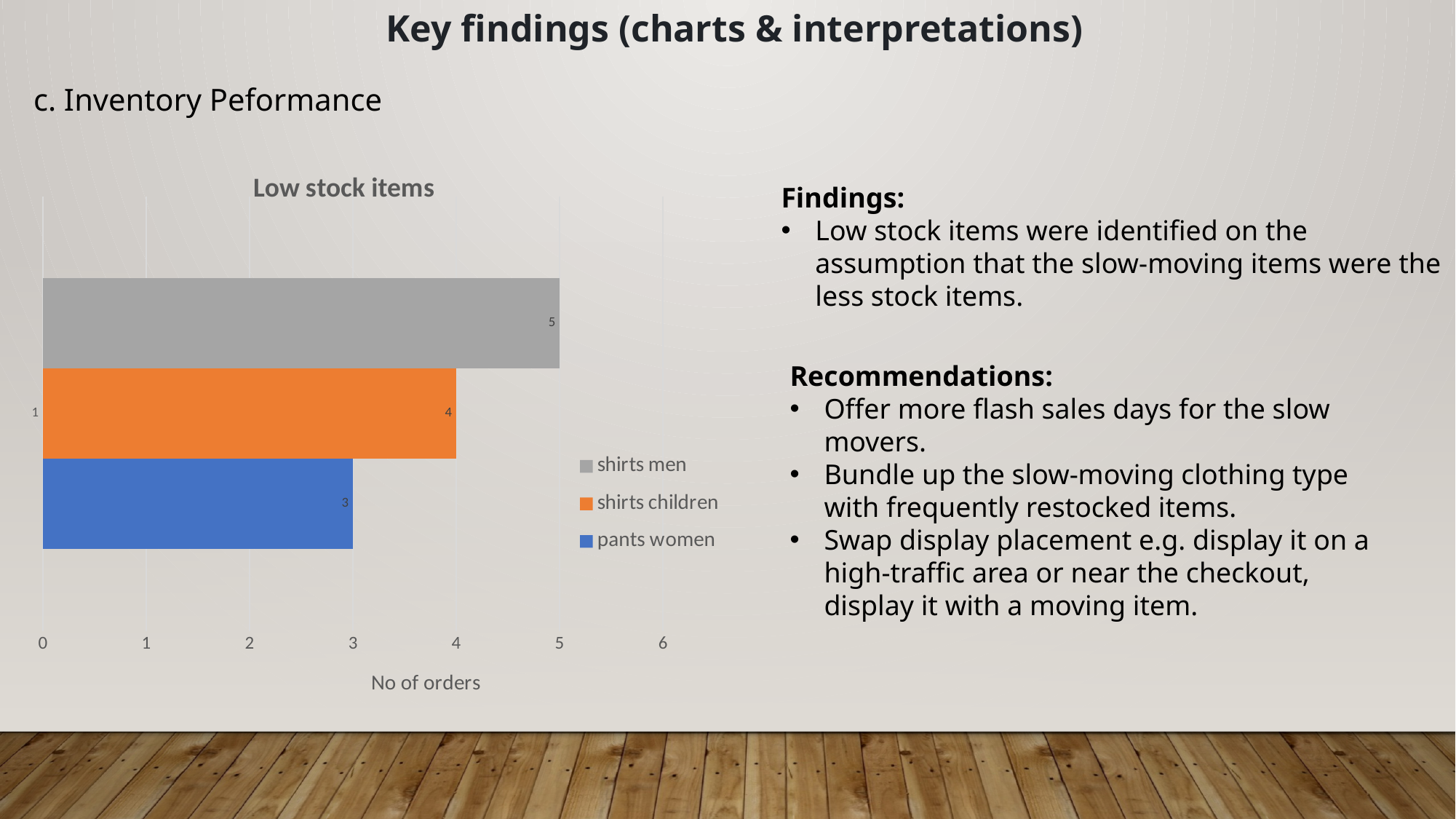
What is the value for shirts children in the Low stock items chart? 4 What is the label of the horizontal axis in the Low stock items chart? No of orders Is the value for shirts men greater or less than 4? greater What is the difference between the values for shirts men and pants women? 2 Which series has the highest value in the Low stock items chart? shirts men What kind of chart is the Low stock items chart? bar chart What is the value for pants women in the Low stock items chart? 3 Which is larger, the value for shirts children or the value for pants women? shirts children How many series does the legend of the Low stock items chart list? 3 What is the value for shirts men in the Low stock items chart? 5 What is the title of the chart on the slide? Low stock items Which series has the lowest value in the Low stock items chart? pants women